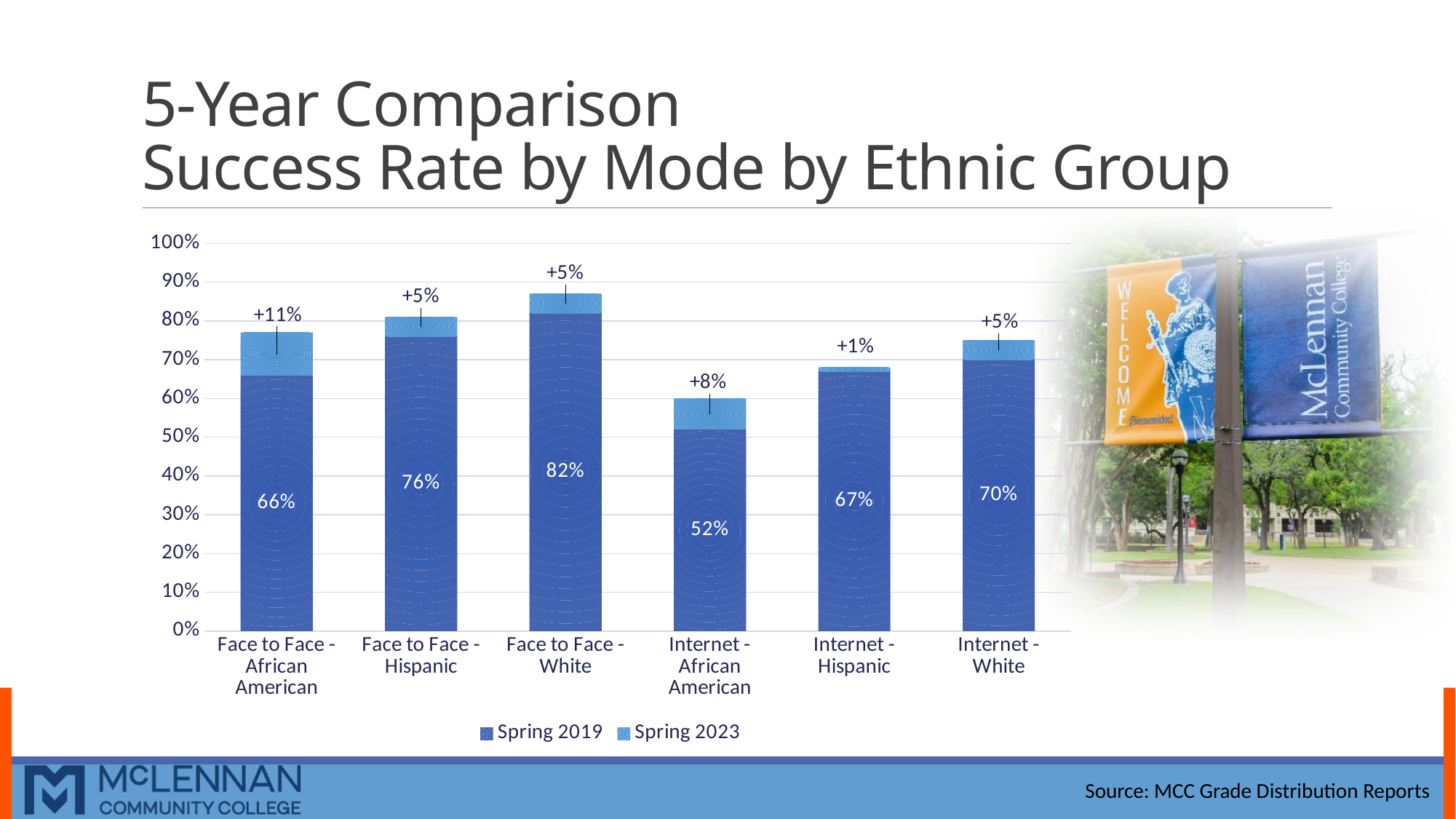
What is the difference between the Spring 2019 success rates for Face to Face - White and Internet - African American? 30% Which category has the lowest Spring 2019 success rate? Internet - African American Is the total height of the Face to Face - White bar greater or less than 80%? greater What change is labeled on the Spring 2023 segment for Internet - African American? +8% How many categories are shown on the x axis? 6 What is the Spring 2019 success rate for Face to Face - African American? 66% What kind of chart is shown on the slide? Stacked bar chart What is the Spring 2019 success rate for Internet - Hispanic? 67% Which has a higher Spring 2019 success rate, Face to Face - Hispanic or Internet - White? Face to Face - Hispanic How many series does the legend list? 2 Which category has the highest Spring 2019 success rate? Face to Face - White Which category shows the largest labeled increase for Spring 2023? Face to Face - African American